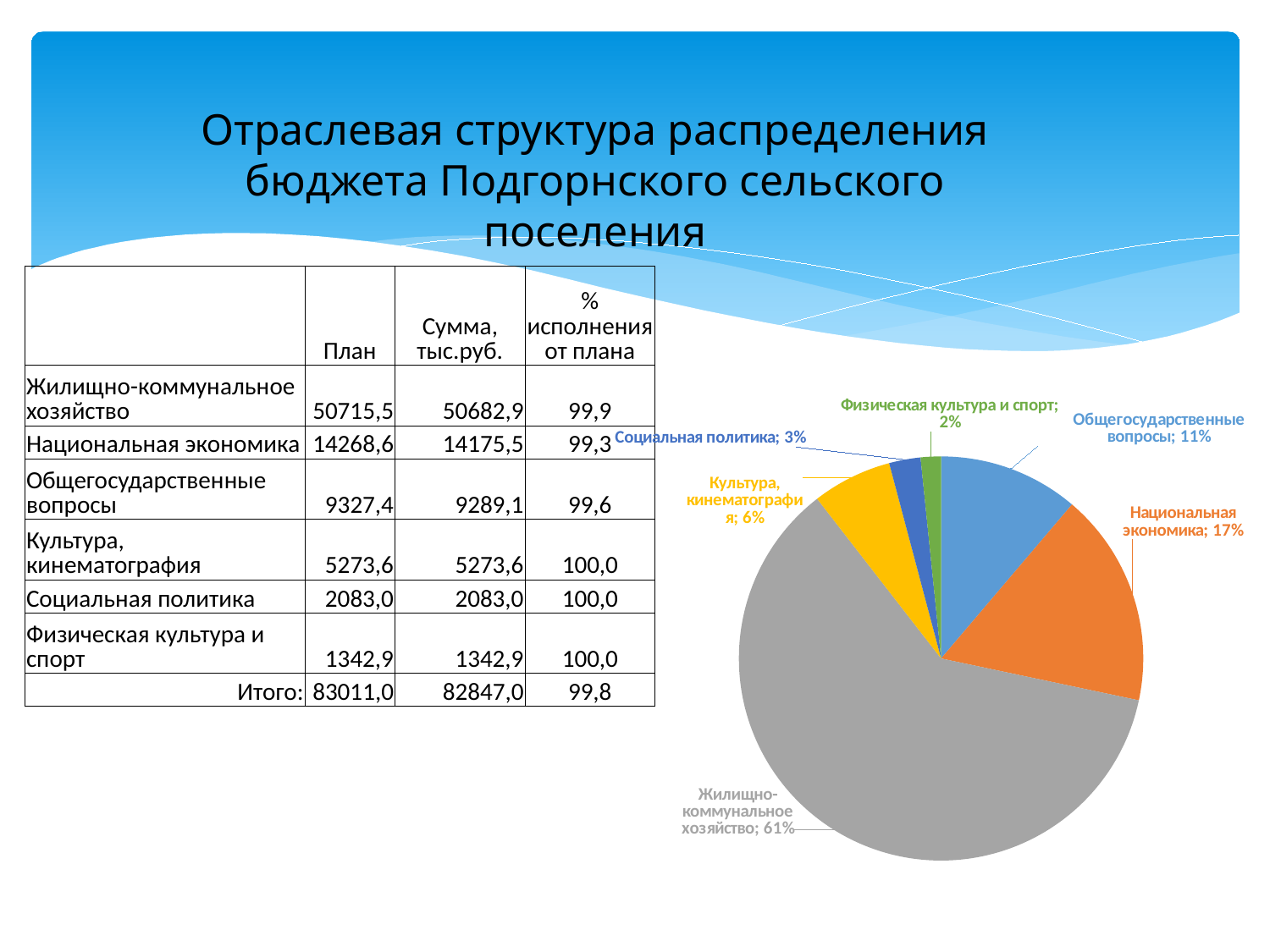
What share of the pie does Культура, кинематография have? 6% What is the difference in percentage points between the Жилищно-коммунальное хозяйство slice and the Национальная экономика slice? 44 What share of the pie does Общегосударственные вопросы have? 11% Which category has the largest slice of the pie chart? Жилищно-коммунальное хозяйство What colour is the Жилищно-коммунальное хозяйство slice in the pie chart? grey How many slices does the pie chart have? 6 What share of the pie does Социальная политика have? 3% What kind of chart is shown on the slide? pie chart Which category has the smallest slice of the pie chart? Физическая культура и спорт Which slice is larger: Национальная экономика or Общегосударственные вопросы? Национальная экономика